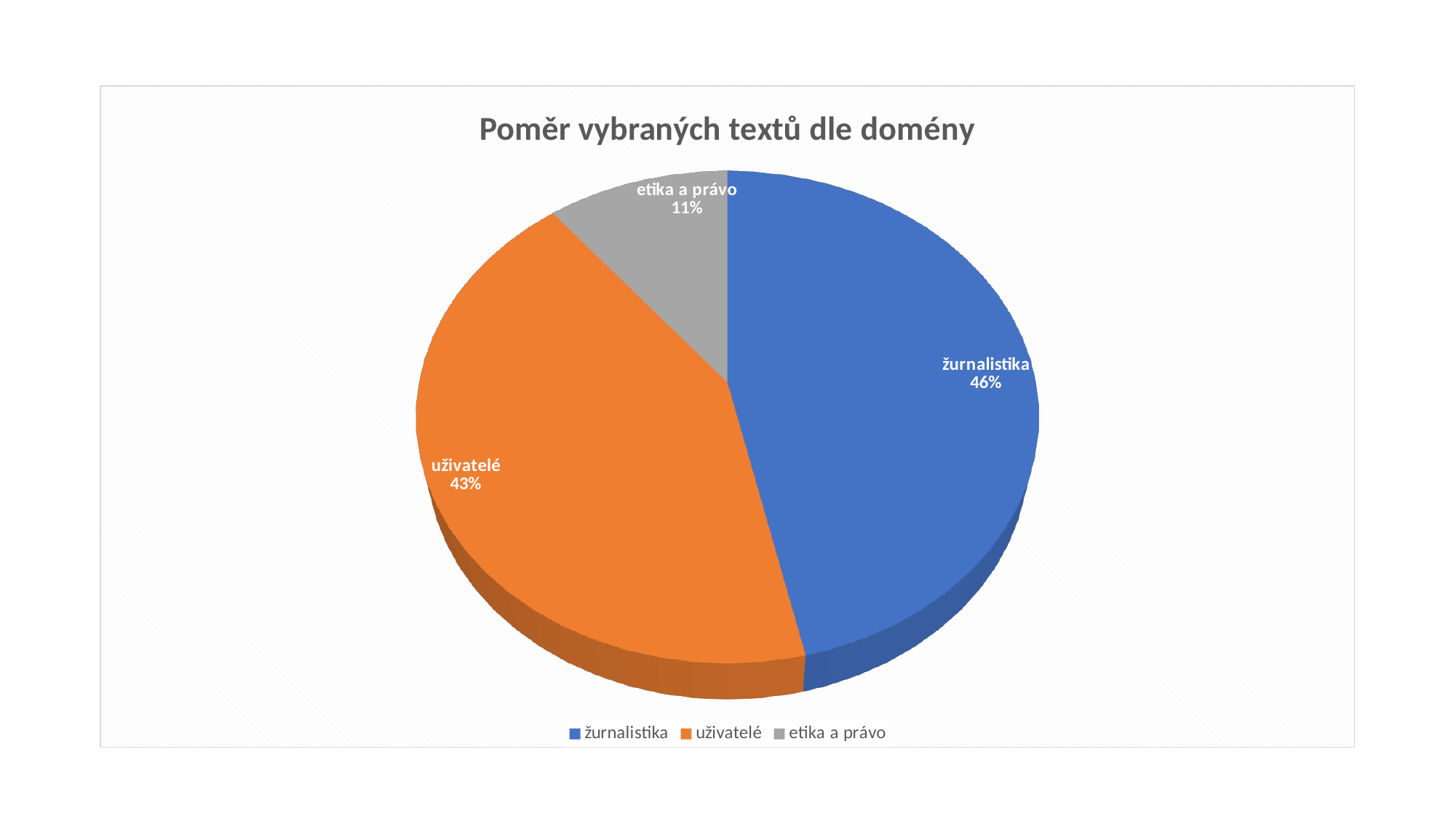
Which colour represents etika a právo in the legend? grey Which category has the largest slice? žurnalistika Which category has the smallest slice? etika a právo How many categories are shown in the pie chart? 3 What is the difference in percentage points between žurnalistika and uživatelé? 3 What share of the pie does žurnalistika have? 46% What share of the pie does uživatelé have? 43% Which is larger, the share for uživatelé or the share for etika a právo? uživatelé What is the title of the chart? Poměr vybraných textů dle domény What kind of chart is shown on the slide? pie chart What is the difference in percentage points between uživatelé and etika a právo? 32 What share of the pie does etika a právo have? 11%